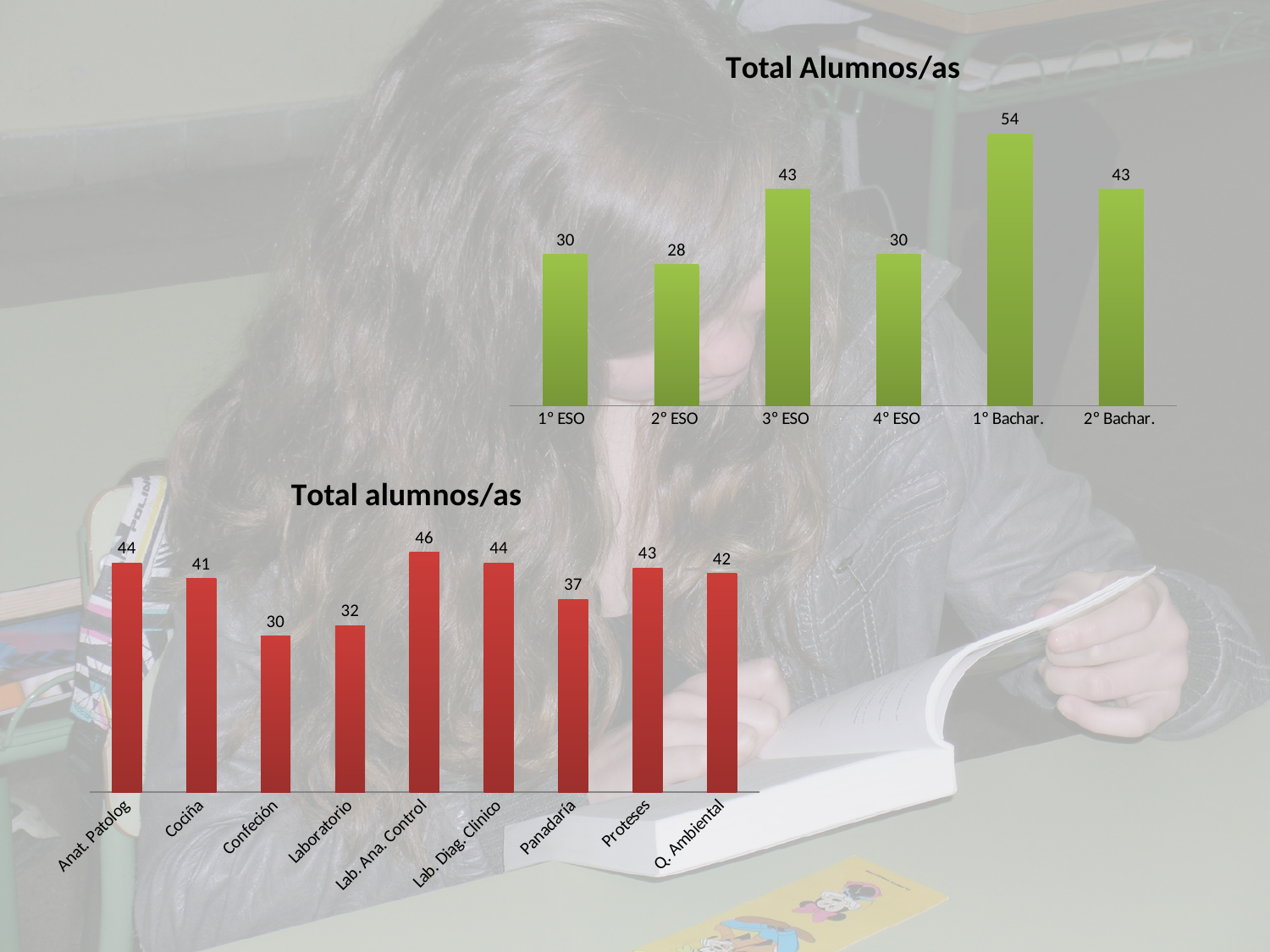
What is the title of the green chart at the top right of the slide? Total Alumnos/as In the red chart at the bottom left of the slide, what is the difference between Lab. Ana. Control and Laboratorio? 14 In the red chart at the bottom left of the slide, what is the value for Panadaría? 37 In the red chart at the bottom left of the slide, which category has the lowest value? Confeción In the green chart at the top right of the slide, which is larger, 3° ESO or 4° ESO? 3° ESO What type of chart is the red chart at the bottom left of the slide? Bar chart In the red chart at the bottom left of the slide, which category has the highest value? Lab. Ana. Control In the green chart at the top right of the slide, which category has the lowest value? 2° ESO In the green chart at the top right of the slide, how many categories are shown? 6 In the green chart at the top right of the slide, what is the difference between 1° Bachar. and 2° ESO? 26 In the red chart at the bottom left of the slide, how many categories are shown? 9 In the green chart at the top right of the slide, what is the value for 1° Bachar.? 54